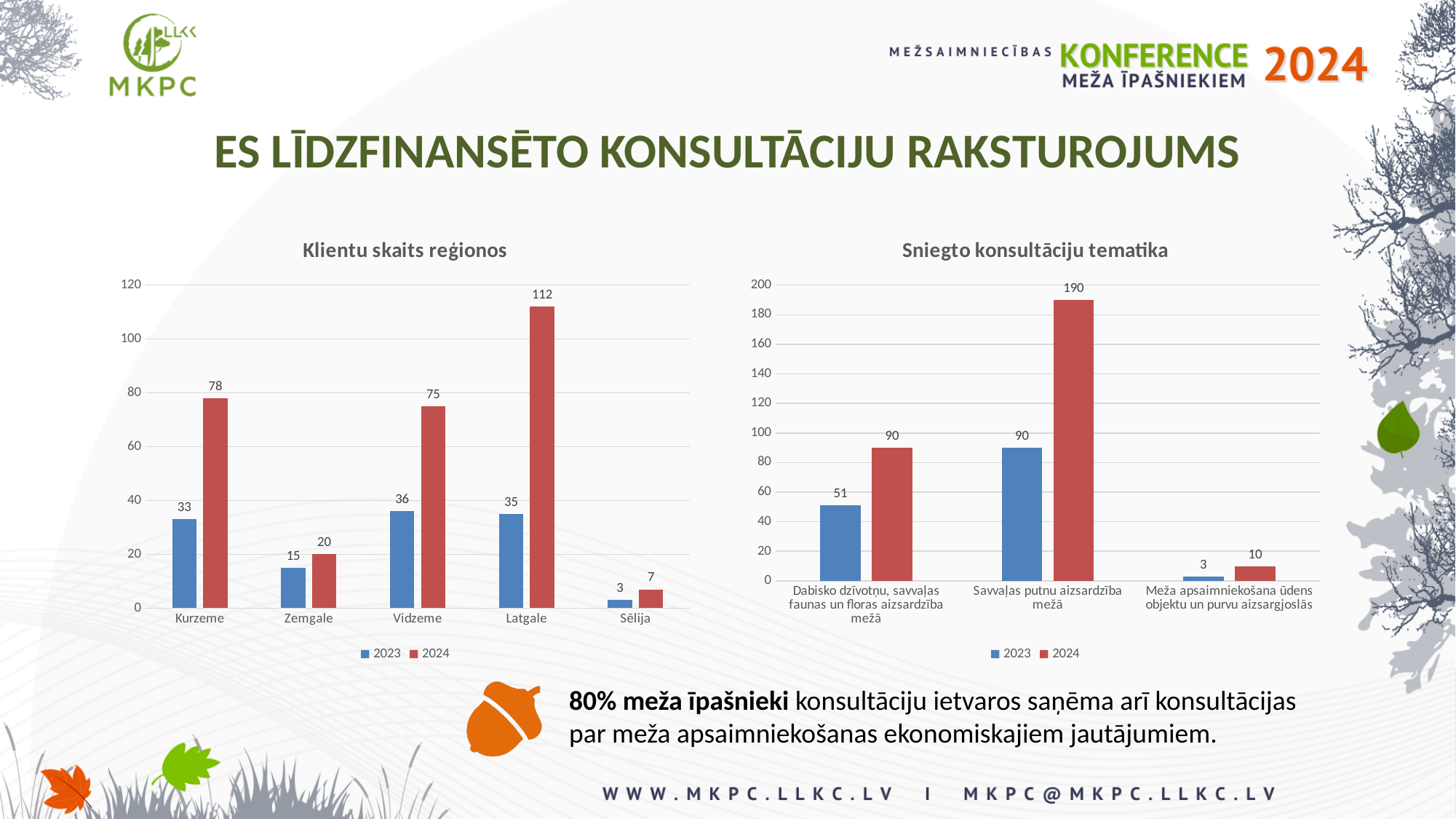
In the 'Sniegto konsultāciju tematika' chart, what is the 2024 value for 'Savvaļas putnu aizsardzība mežā'? 190 In the 'Sniegto konsultāciju tematika' chart, what is the 2023 value for 'Meža apsaimniekošana ūdens objektu un purvu aizsargjoslās'? 3 In the 'Klientu skaits reģionos' chart, what is the 2024 value for Latgale? 112 In the 'Klientu skaits reģionos' chart, is the 2024 value for Vidzeme greater or less than 60? greater In the 'Klientu skaits reģionos' chart, what is the difference between the 2024 and 2023 values for Kurzeme? 45 How many series does the legend of the 'Sniegto konsultāciju tematika' chart list? 2 In the 'Klientu skaits reģionos' chart, which region has the lowest 2023 value? Sēlija In the 'Sniegto konsultāciju tematika' chart, which is larger: the 2023 value for 'Dabisko dzīvotņu, savvaļas faunas un floras aizsardzība mežā' or the 2023 value for 'Savvaļas putnu aizsardzība mežā'? Savvaļas putnu aizsardzība mežā What kind of chart is 'Sniegto konsultāciju tematika'? Bar chart In the 'Klientu skaits reģionos' chart, which region has the highest 2024 value? Latgale In the 'Klientu skaits reģionos' chart, how many regions are shown on the x axis? 5 In the 'Klientu skaits reģionos' chart, what is the 2023 value for Zemgale? 15